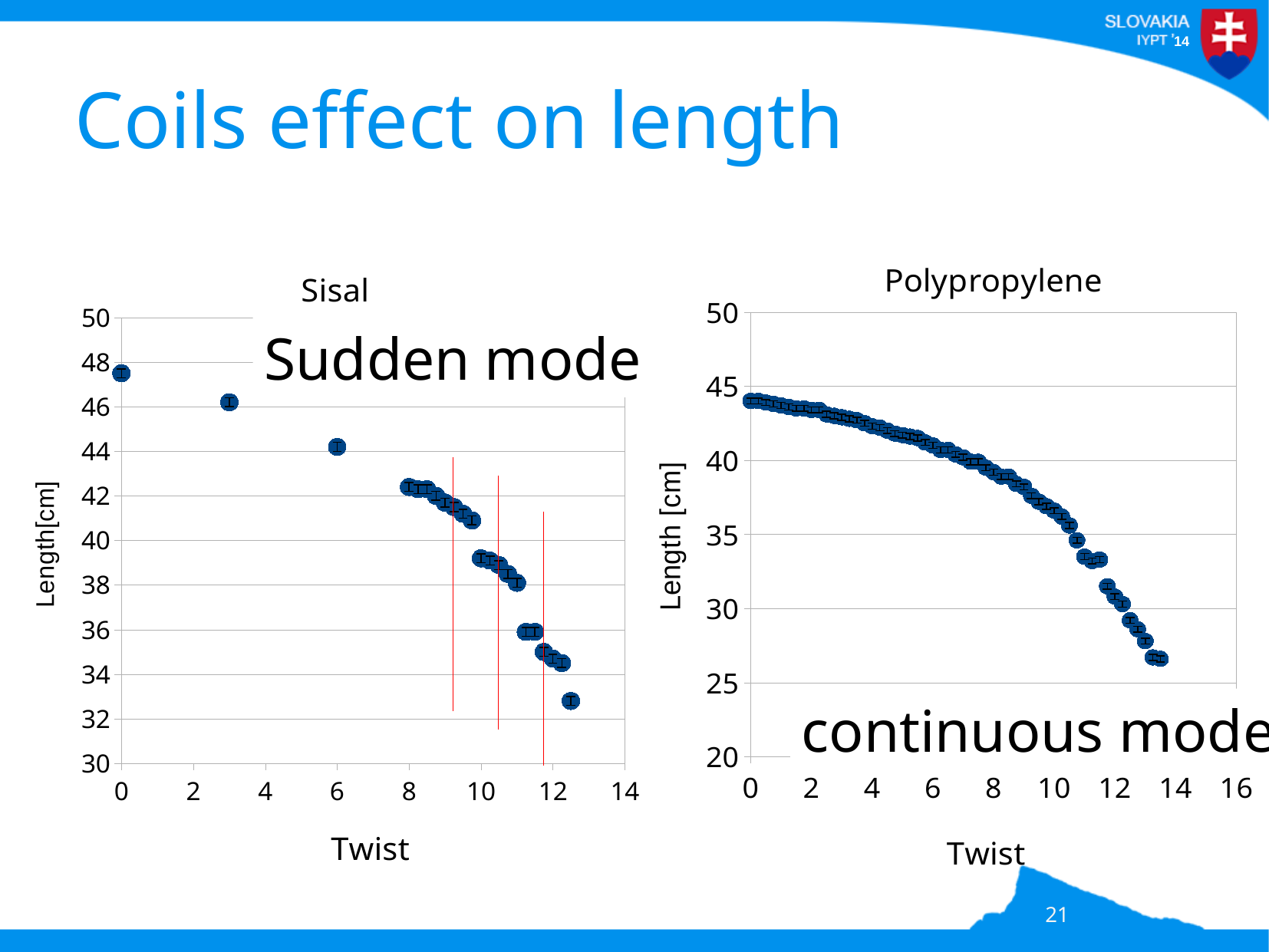
In the Polypropylene chart, is the length at twist 10 greater or less than 35 cm? greater What is the maximum value shown on the x axis of the Polypropylene chart? 16 In the Sisal chart, is the length at twist 0 greater or less than 46 cm? greater In the Polypropylene chart, does length rise or fall as twist increases? fall In the Polypropylene chart, is the length at twist 0 greater or less than 45 cm? less What is the x-axis label of the Sisal chart? Twist What kind of chart is the Sisal chart on the left? scatter chart In the Sisal chart, does length rise or fall as twist increases? fall How many charts are shown on the slide? 2